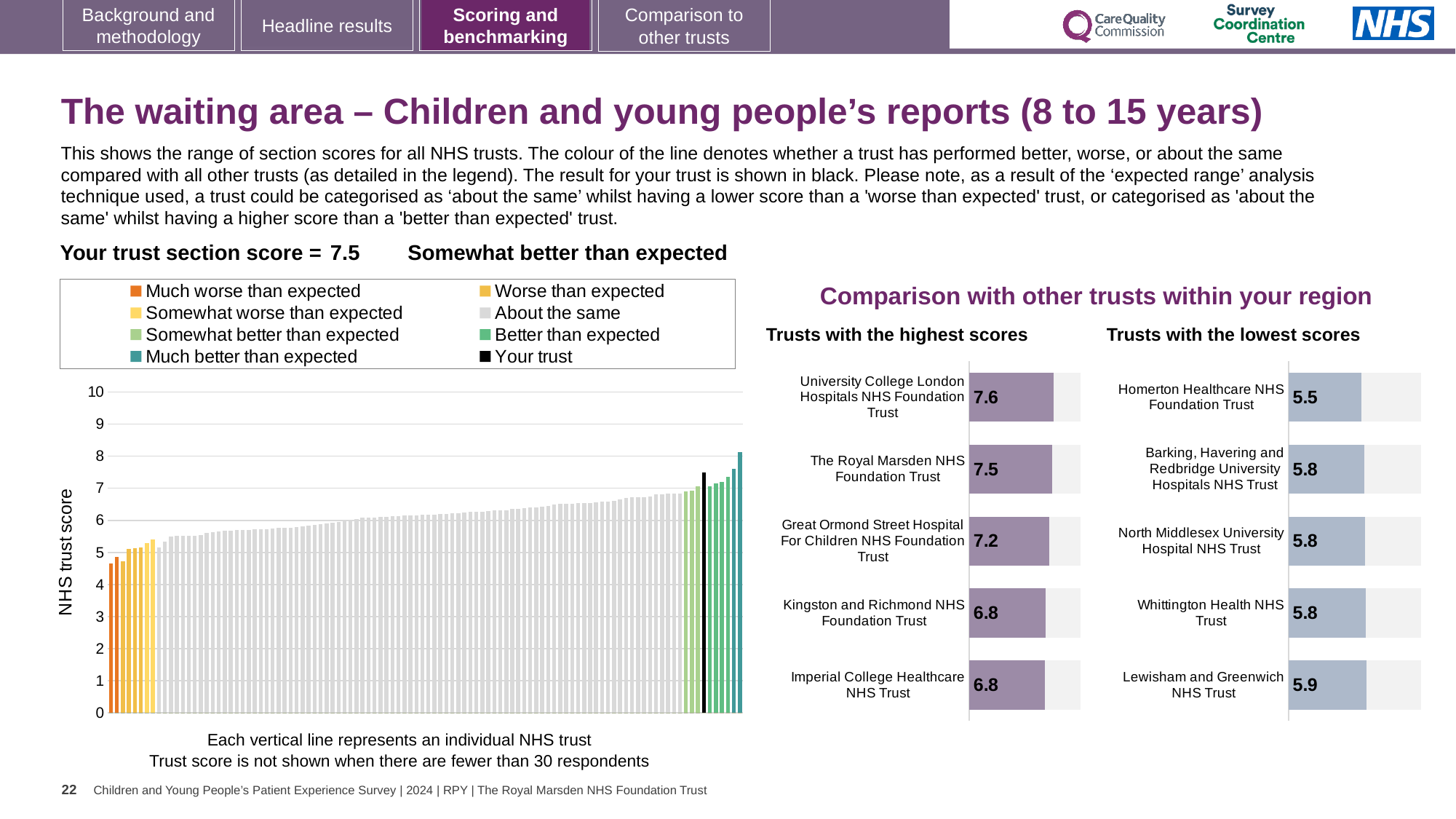
In the 'Trusts with the highest scores' chart, which trust has the highest score? University College London Hospitals NHS Foundation Trust In the 'Trusts with the highest scores' chart, which has the higher score: The Royal Marsden NHS Foundation Trust or Great Ormond Street Hospital For Children NHS Foundation Trust? The Royal Marsden NHS Foundation Trust In the 'Trusts with the lowest scores' chart, what is the score for Lewisham and Greenwich NHS Trust? 5.9 In the NHS trust score chart on the left, is the value of the black 'Your trust' bar greater or less than 7? greater In the 'Trusts with the lowest scores' chart, what is the score for Homerton Healthcare NHS Foundation Trust? 5.5 In the 'Trusts with the highest scores' chart, what is the score for Great Ormond Street Hospital For Children NHS Foundation Trust? 7.2 In the 'Trusts with the highest scores' chart, what is the score for University College London Hospitals NHS Foundation Trust? 7.6 In the 'Trusts with the highest scores' chart, what is the difference between the scores of University College London Hospitals NHS Foundation Trust and Imperial College Healthcare NHS Trust? 0.8 In the 'Trusts with the lowest scores' chart, which trust has the lowest score? Homerton Healthcare NHS Foundation Trust How many entries does the legend of the NHS trust score chart on the left list? 8 How many trusts are shown in the 'Trusts with the lowest scores' chart? 5 In the NHS trust score chart on the left, do the bar values rise or fall from left to right? rise